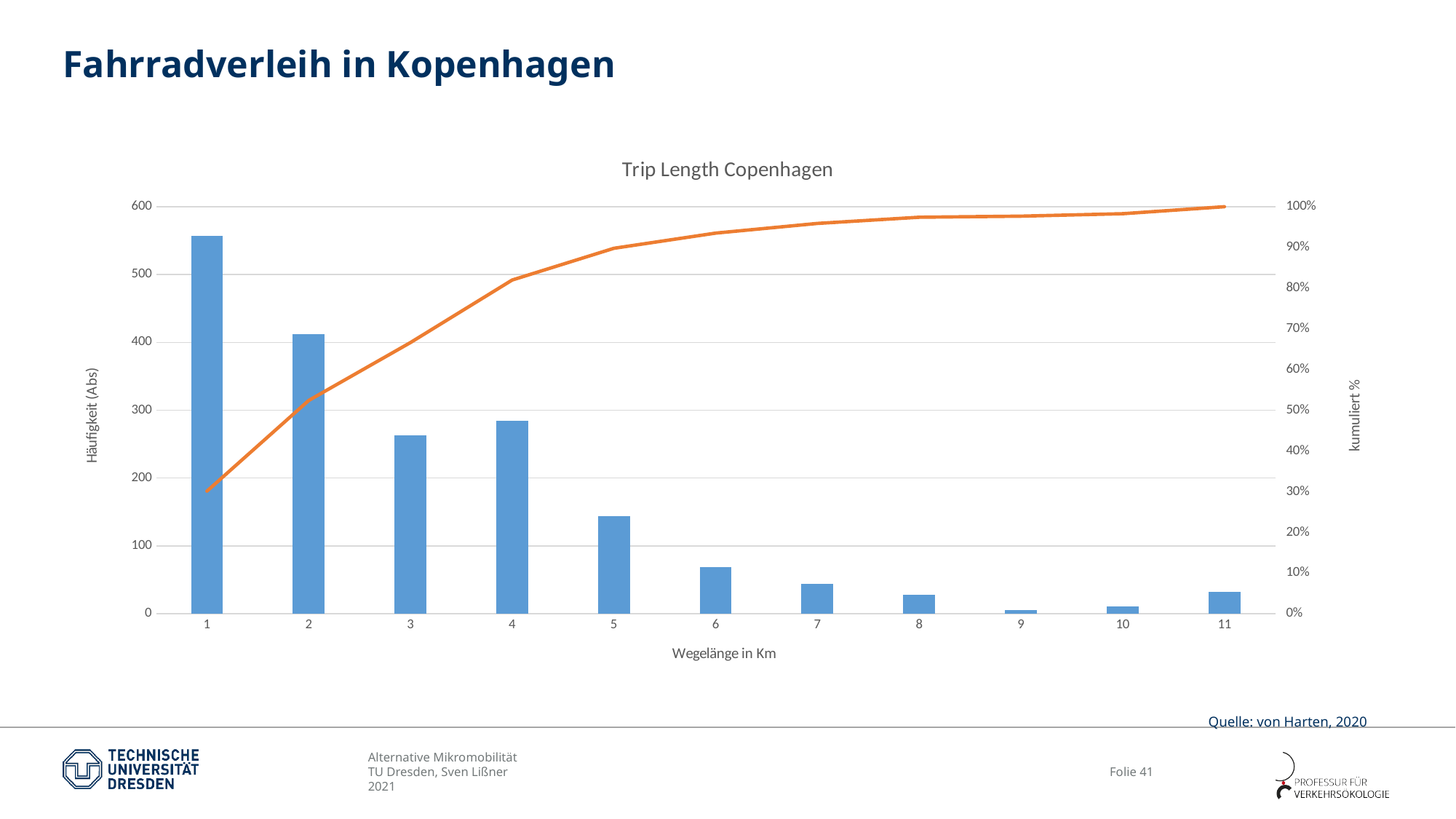
Which trip length (in km) has the highest frequency? 1 Does the cumulative percentage line rise or fall as trip length increases? rise Which has the higher frequency, trip length 10 km or 11 km? 11 km Is the frequency for trip length 6 km greater or less than 100? less Which has the higher frequency, trip length 3 km or 4 km? 4 km What kind of chart is shown on the slide? A bar chart combined with a line chart How many trip length categories are shown on the x axis? 11 Is the frequency for trip length 3 km greater or less than 300? less Is the frequency for trip length 5 km greater or less than 100? greater What is the title of the chart? Trip Length Copenhagen Which trip length (in km) has the lowest frequency? 9